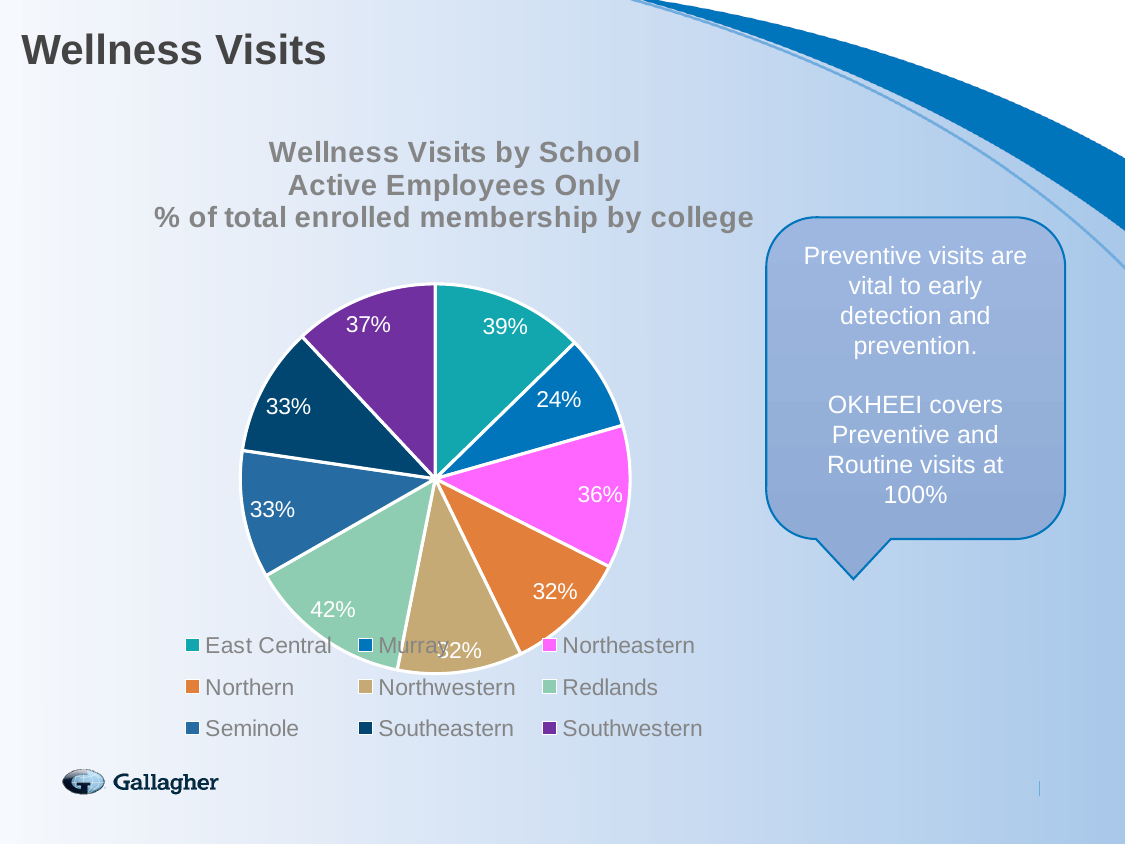
What is the title of the chart? Wellness Visits by School Active Employees Only % of total enrolled membership by college What is the value shown for Redlands? 42% What is the value shown for Murray? 24% Which has a larger value, East Central or Northern? East Central What is the value shown for East Central? 39% What type of chart is shown on the slide? pie chart Which school has the lowest value in the chart? Murray Which school has the highest value in the chart? Redlands What is the value shown for Northeastern? 36% How many schools are listed in the chart legend? 9 What is the difference between the values for Redlands and Murray? 18% What is the value shown for Southwestern? 37%